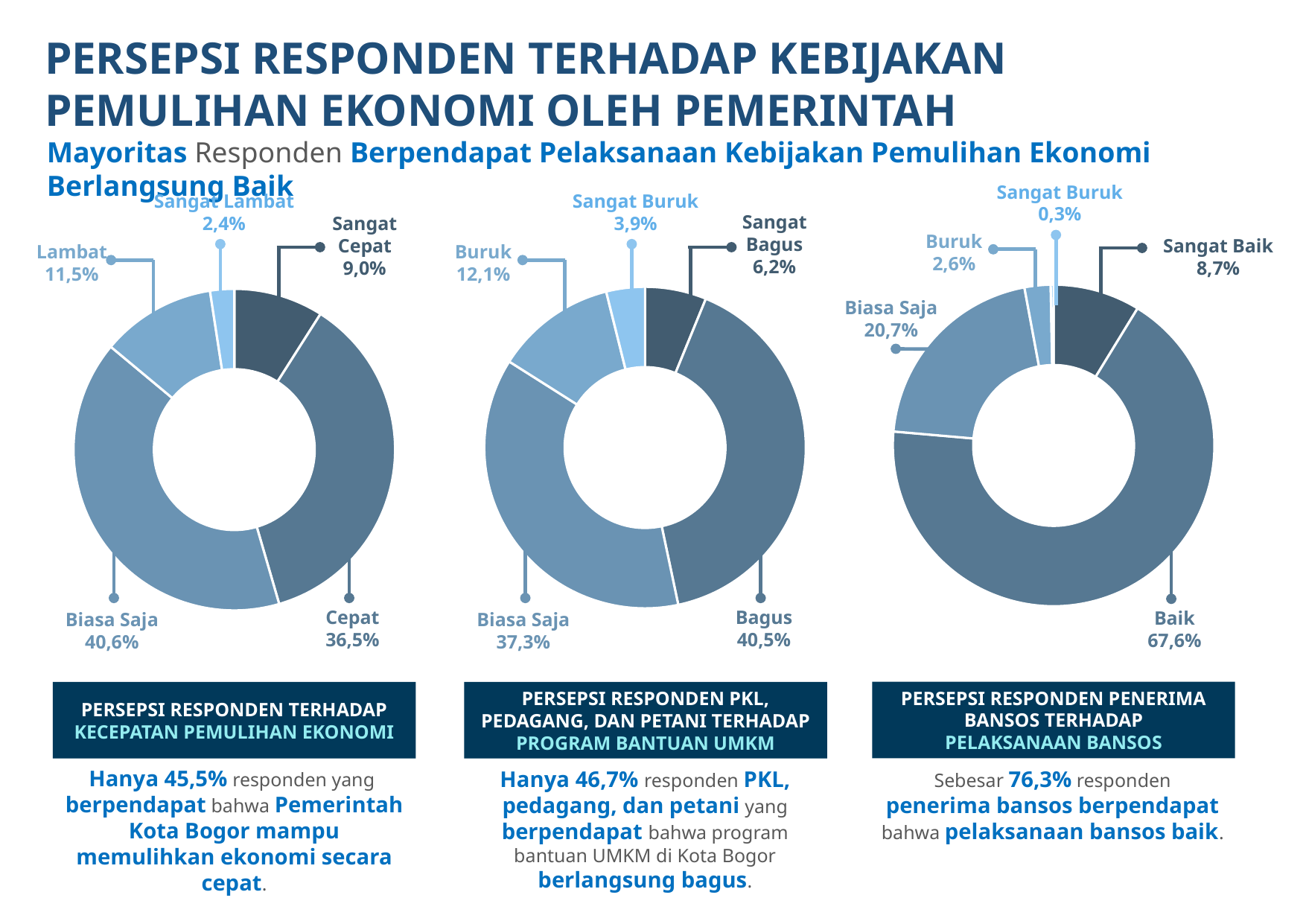
In the right chart (Pelaksanaan Bansos), what percentage of respondents answered "Baik"? 67,6% In the middle chart (Program Bantuan UMKM), which category has the largest share? Bagus In the middle chart (Program Bantuan UMKM), what percentage of respondents answered "Bagus"? 40,5% In the right chart (Pelaksanaan Bansos), which is larger: "Biasa Saja" or "Sangat Baik"? Biasa Saja In the middle chart (Program Bantuan UMKM), what is the difference between the "Buruk" and "Sangat Buruk" shares? 8,2% In the left chart (Kecepatan Pemulihan Ekonomi), which category has the smallest share? Sangat Lambat In the right chart (Pelaksanaan Bansos), which category has the smallest share? Sangat Buruk In the left chart (Kecepatan Pemulihan Ekonomi), what percentage of respondents answered "Biasa Saja"? 40,6% In the left chart (Kecepatan Pemulihan Ekonomi), what is the combined share of "Sangat Cepat" and "Cepat"? 45,5% What is the title shown in the box below the right chart? PERSEPSI RESPONDEN PENERIMA BANSOS TERHADAP PELAKSANAAN BANSOS How many categories does each donut chart on the slide show? 5 What type of chart is used for the three charts on the slide? Donut (pie) chart